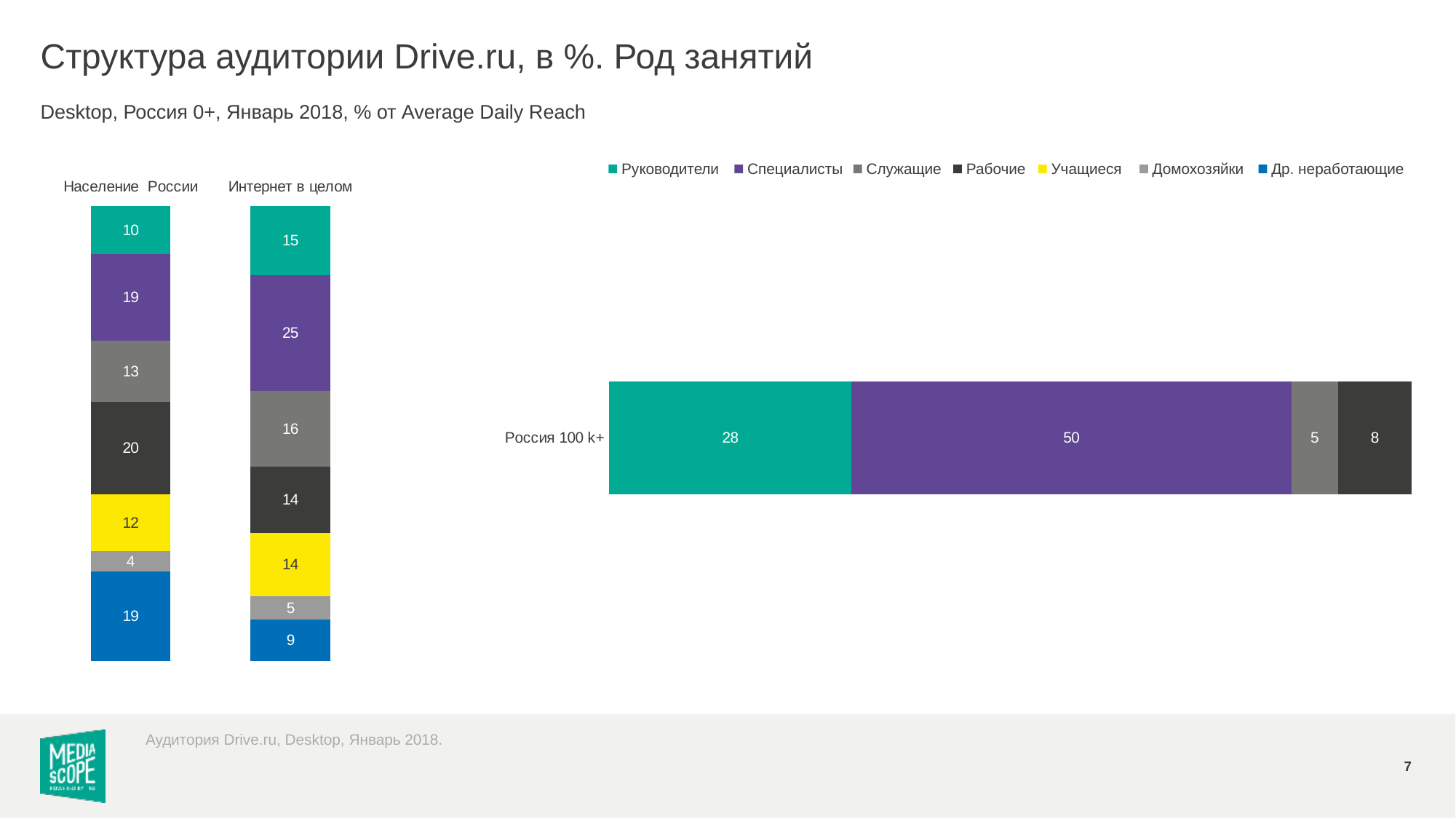
What colour represents Учащиеся in the legend? Yellow In the 'Интернет в целом' bar, what is the difference between Специалисты and Руководители? 10 How many series does the legend list? 7 In the 'Россия 100 k+' bar, what is the value for Руководители? 28 In the 'Интернет в целом' bar, what is the value for Специалисты? 25 In the 'Население России' bar, which is larger: Рабочие or Специалисты? Рабочие In the 'Интернет в целом' bar, what is the value for Др. неработающие? 9 In the 'Россия 100 k+' bar, which category has the largest segment? Специалисты In the 'Население России' bar, which category has the smallest segment? Домохозяйки What kind of chart is the 'Россия 100 k+' chart? Stacked bar chart In the 'Население России' bar, what is the value for Рабочие? 20 What is the total of the labelled segments in the 'Россия 100 k+' bar? 91